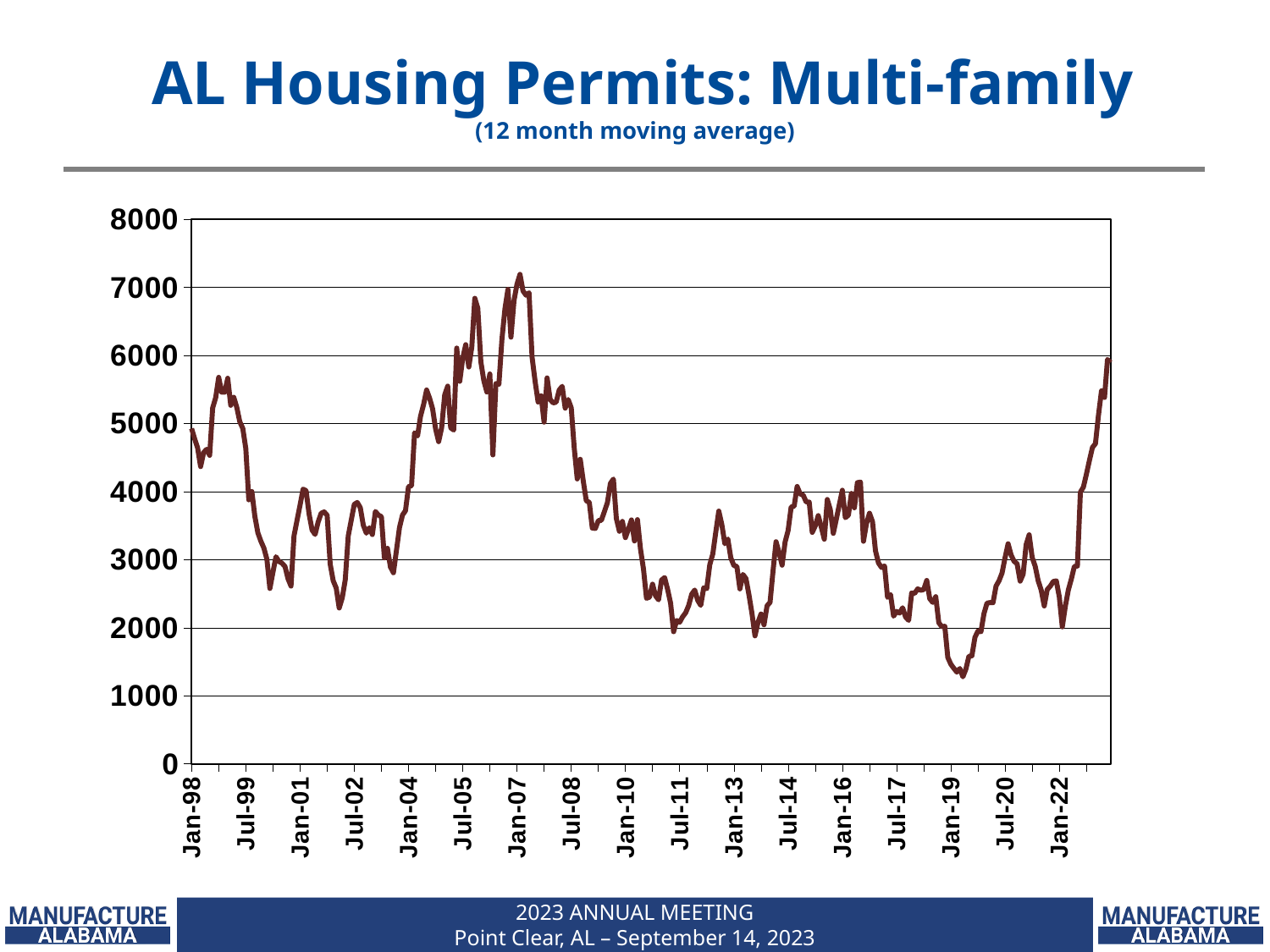
What kind of chart is shown on the slide? line chart Is the value at Jul-08 greater or less than 5000? greater Is the value at Jan-99 greater or less than 5000? greater Around which x-axis label does the line reach its highest point? Jan-07 What is the title of the chart on the slide? AL Housing Permits: Multi-family Does the line rise or fall between Jan-22 and the end of the series? rise Around which x-axis label does the line reach its lowest point? Jan-19 Is the value at Jul-17 greater or less than 3000? less According to the subtitle, what kind of average does the chart plot? 12 month moving average Which is larger, the value at Jan-07 or the value at Jan-19? Jan-07